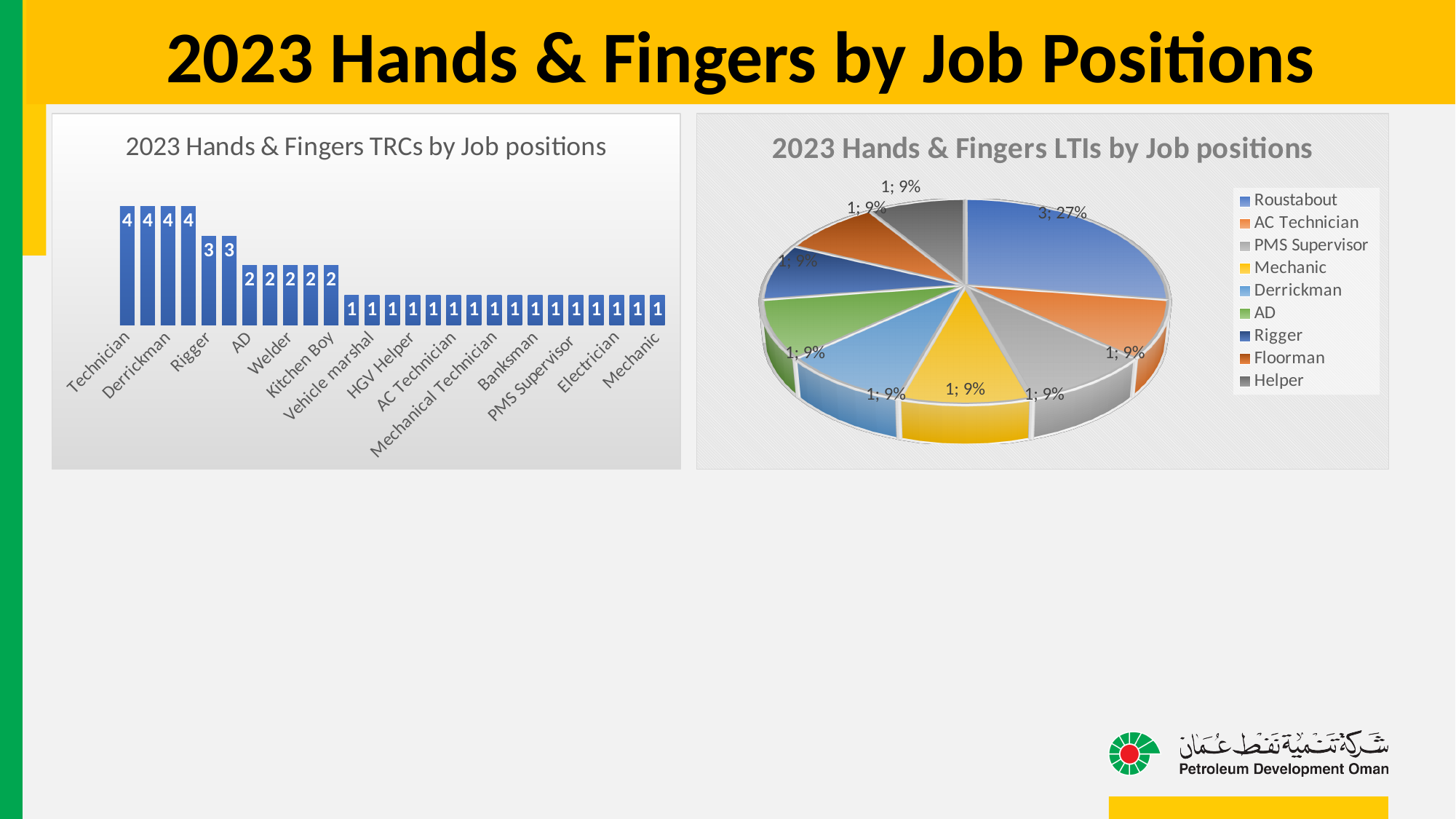
In the '2023 Hands & Fingers LTIs by Job positions' pie chart, which job position has the largest slice? Roustabout In the '2023 Hands & Fingers TRCs by Job positions' bar chart, what is the value for Rigger? 3 What kind of chart is the '2023 Hands & Fingers TRCs by Job positions' chart on the left? bar chart In the '2023 Hands & Fingers LTIs by Job positions' pie chart, what share does Mechanic have? 9% In the '2023 Hands & Fingers TRCs by Job positions' bar chart, what is the value for Mechanic? 1 In the '2023 Hands & Fingers TRCs by Job positions' bar chart, what is the difference between the values for Technician and Mechanic? 3 In the '2023 Hands & Fingers LTIs by Job positions' pie chart, what is the value for Roustabout? 3 In the '2023 Hands & Fingers LTIs by Job positions' pie chart, what share does Roustabout have? 27% How many job positions does the legend of the '2023 Hands & Fingers LTIs by Job positions' pie chart list? 9 What kind of chart is the '2023 Hands & Fingers LTIs by Job positions' chart on the right? pie chart In the '2023 Hands & Fingers TRCs by Job positions' bar chart, what is the value for Technician? 4 In the '2023 Hands & Fingers TRCs by Job positions' bar chart, do the values rise or fall from left to right along the x axis? fall